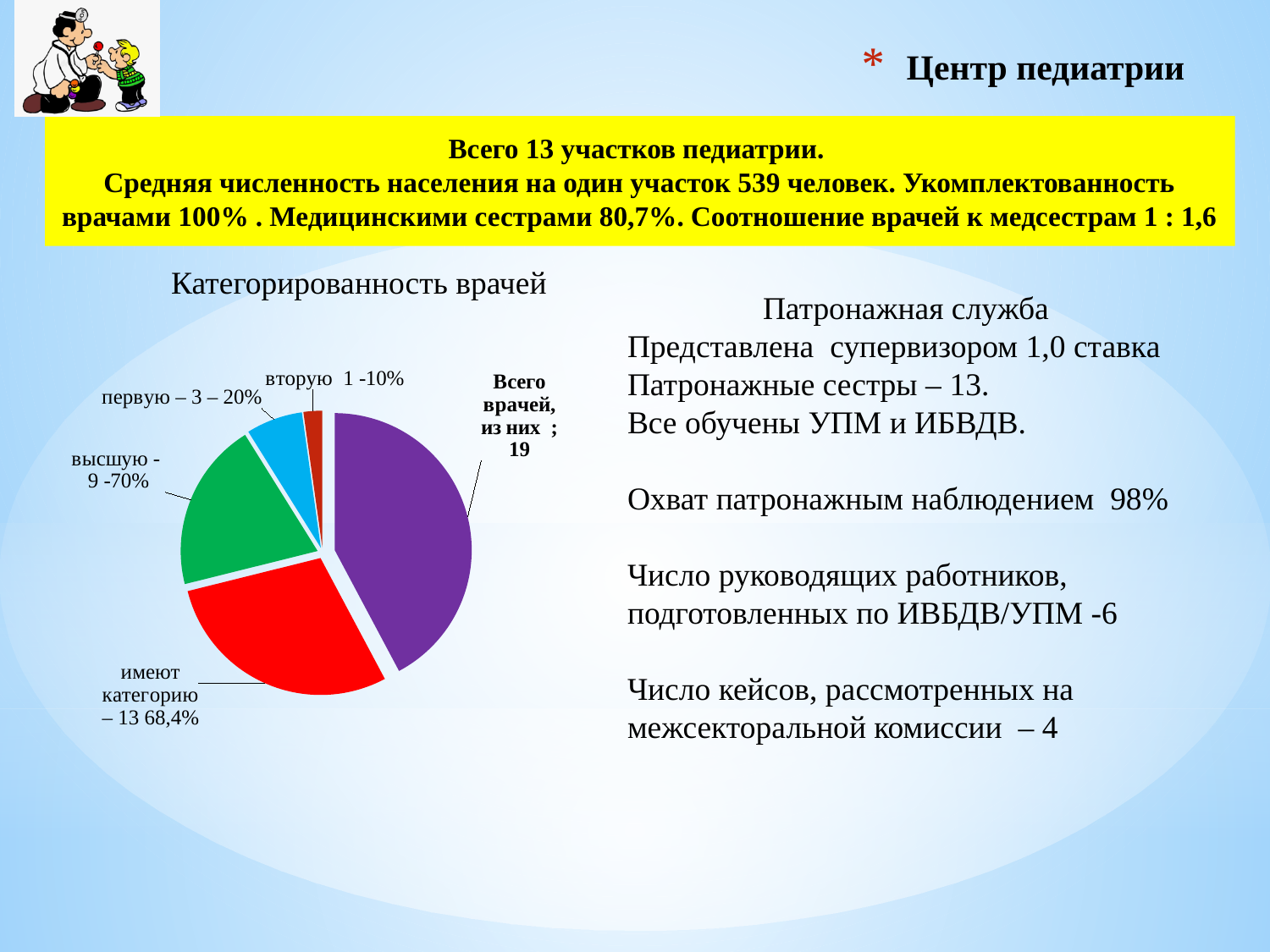
How many slices does the pie chart have? 5 What number is shown for the slice "вторую" in the pie chart? 1 Which slice of the pie chart is the smallest? вторую What value is shown for the slice "Всего врачей, из них" in the pie chart? 19 What kind of chart is shown under the heading "Категорированность врачей"? pie chart What number is shown for the slice "первую" in the pie chart? 3 What is the difference between the values for "имеют категорию" and "высшую"? 4 How many doctors are shown in the slice "имеют категорию"? 13 What percentage is printed next to the slice "высшую"? 70% What number is shown for the slice "высшую" in the pie chart? 9 What is the title of the pie chart on the slide? Категорированность врачей Which slice of the pie chart is the largest? Всего врачей, из них